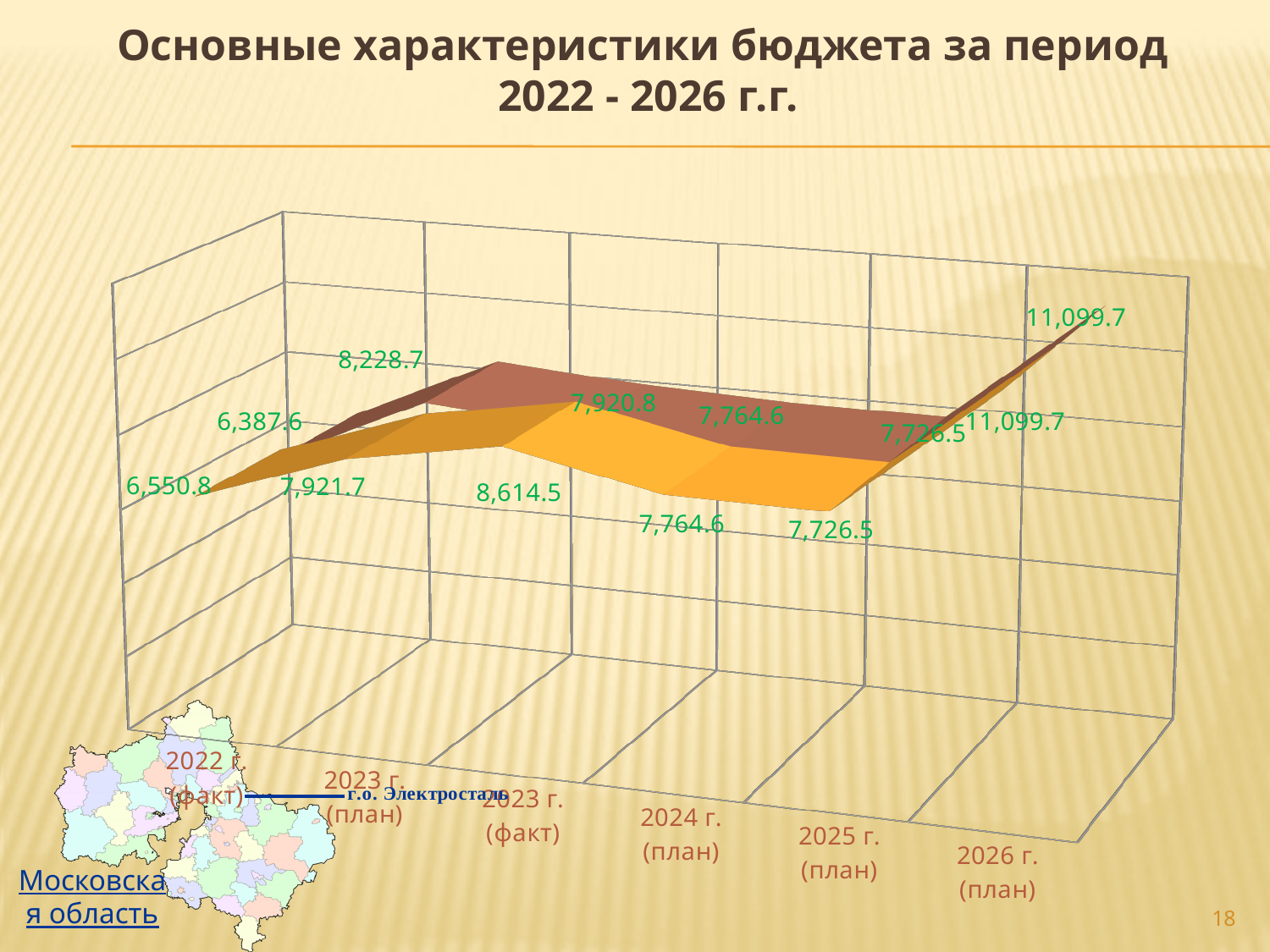
What is the difference between the front (orange) series values for 2023 г. (факт) and 2022 г. (факт)? 2,063.7 How many categories are shown along the x axis of the chart? 6 Which category has the highest value in the front (orange) series? 2026 г. (план) In the front (orange) series, which is larger: the value for 2023 г. (план) or 2023 г. (факт)? 2023 г. (факт) What is the value of the front (orange) series for 2023 г. (факт)? 8,614.5 Which category has the lowest value in the front (orange) series? 2022 г. (факт) What is the value of the back (brown) series for 2023 г. (план)? 8,228.7 What is the title of the slide? Основные характеристики бюджета за период 2022 - 2026 г.г. What value is shown for 2024 г. (план)? 7,764.6 What value is shown for 2026 г. (план)? 11,099.7 What kind of chart is shown on the slide? 3D line chart What is the value of the front (orange) series for 2022 г. (факт)? 6,550.8